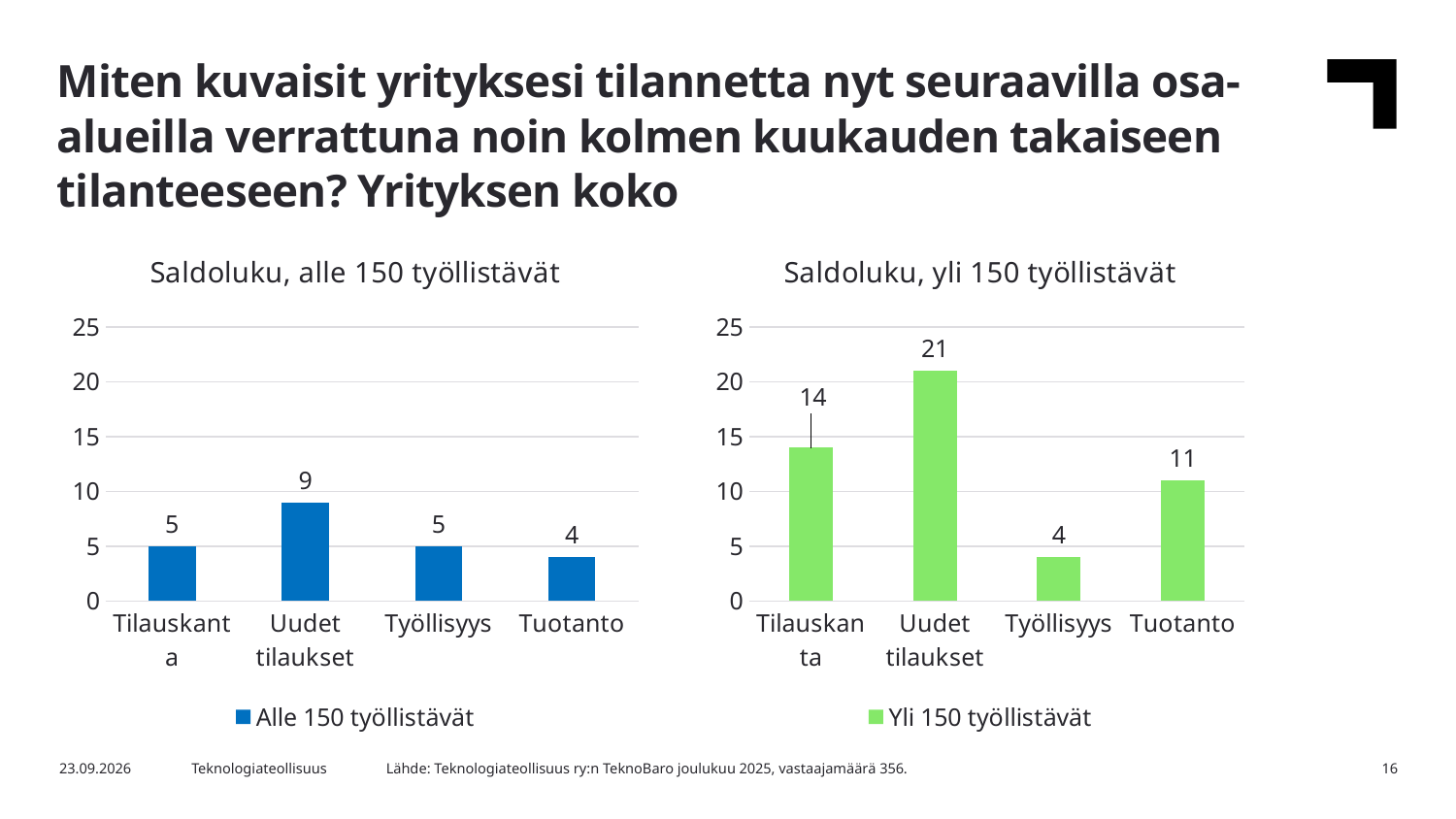
In the chart titled "Saldoluku, alle 150 työllistävät", which category has the lowest value? Tuotanto In the chart titled "Saldoluku, yli 150 työllistävät", what is the difference between the values for Uudet tilaukset and Työllisyys? 17 In the chart titled "Saldoluku, yli 150 työllistävät", is the value for Uudet tilaukset greater or less than 20? greater What is the legend entry of the chart titled "Saldoluku, yli 150 työllistävät"? Yli 150 työllistävät In the chart titled "Saldoluku, yli 150 työllistävät", what is the value for Tilauskanta? 14 How many categories are shown in the chart titled "Saldoluku, alle 150 työllistävät"? 4 In the chart titled "Saldoluku, alle 150 työllistävät", what is the difference between the values for Uudet tilaukset and Tuotanto? 5 What kind of chart is the chart titled "Saldoluku, alle 150 työllistävät"? Bar chart How many series does the legend of the chart titled "Saldoluku, yli 150 työllistävät" list? 1 In the chart titled "Saldoluku, yli 150 työllistävät", which category has the highest value? Uudet tilaukset Which is larger: the value for Tuotanto in the chart titled "Saldoluku, alle 150 työllistävät" or the value for Tuotanto in the chart titled "Saldoluku, yli 150 työllistävät"? Saldoluku, yli 150 työllistävät In the chart titled "Saldoluku, alle 150 työllistävät", what is the value for Uudet tilaukset? 9